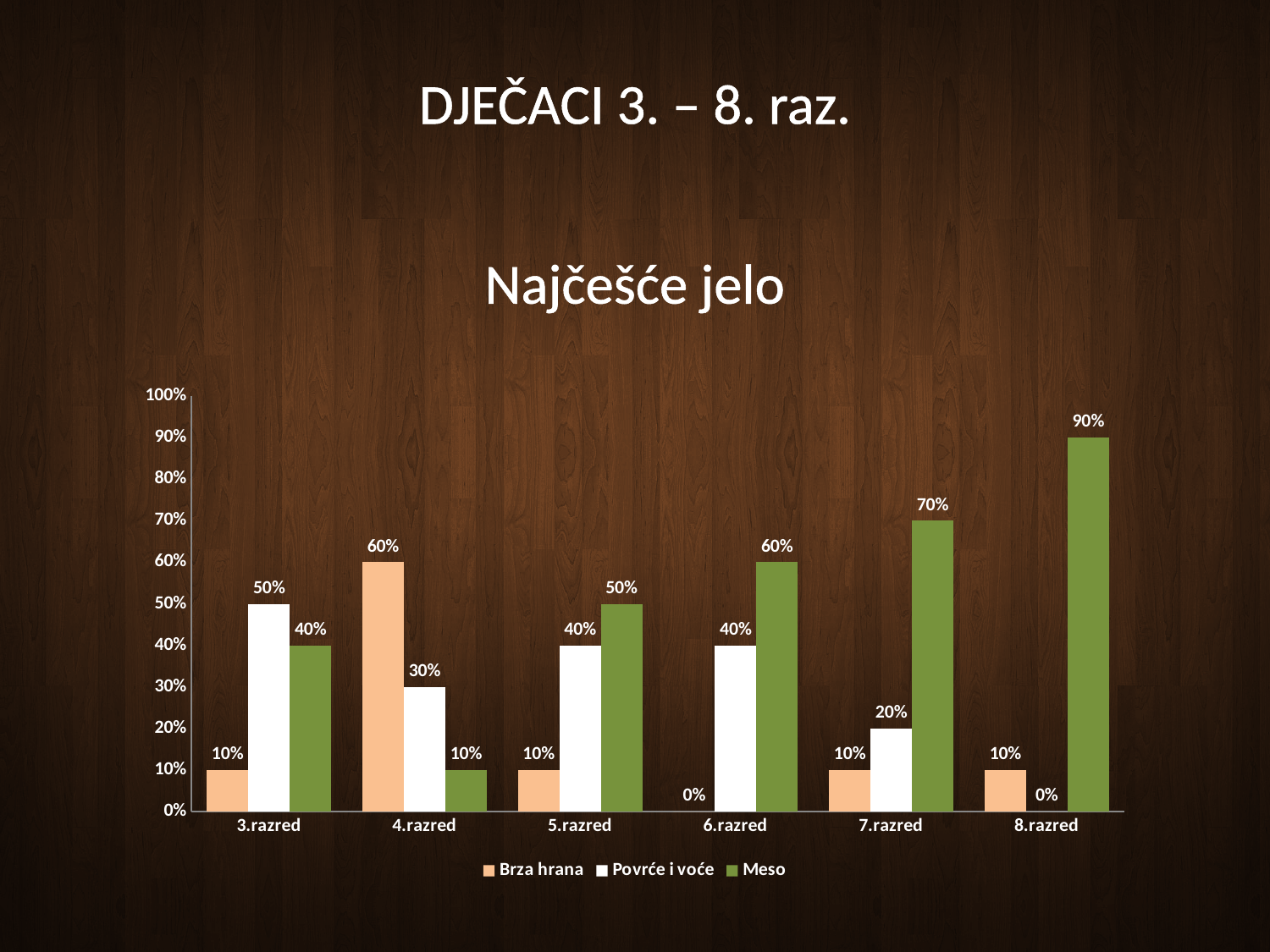
What is the value for Povrće i voće in 7.razred? 20% Which is larger in 3.razred, Povrće i voće or Meso? Povrće i voće What is the difference between the Meso value and the Brza hrana value in 7.razred? 60% How many series does the legend list? 3 Do the Meso values rise or fall from 5.razred to 8.razred? rise What is the value for Brza hrana in 4.razred? 60% How many categories are shown on the x axis? 6 What is the title of the chart? Najčešće jelo Which category has the highest value for Meso? 8.razred Which category has the lowest value for Povrće i voće? 8.razred What is the value for Meso in 8.razred? 90% What kind of chart is shown? bar chart